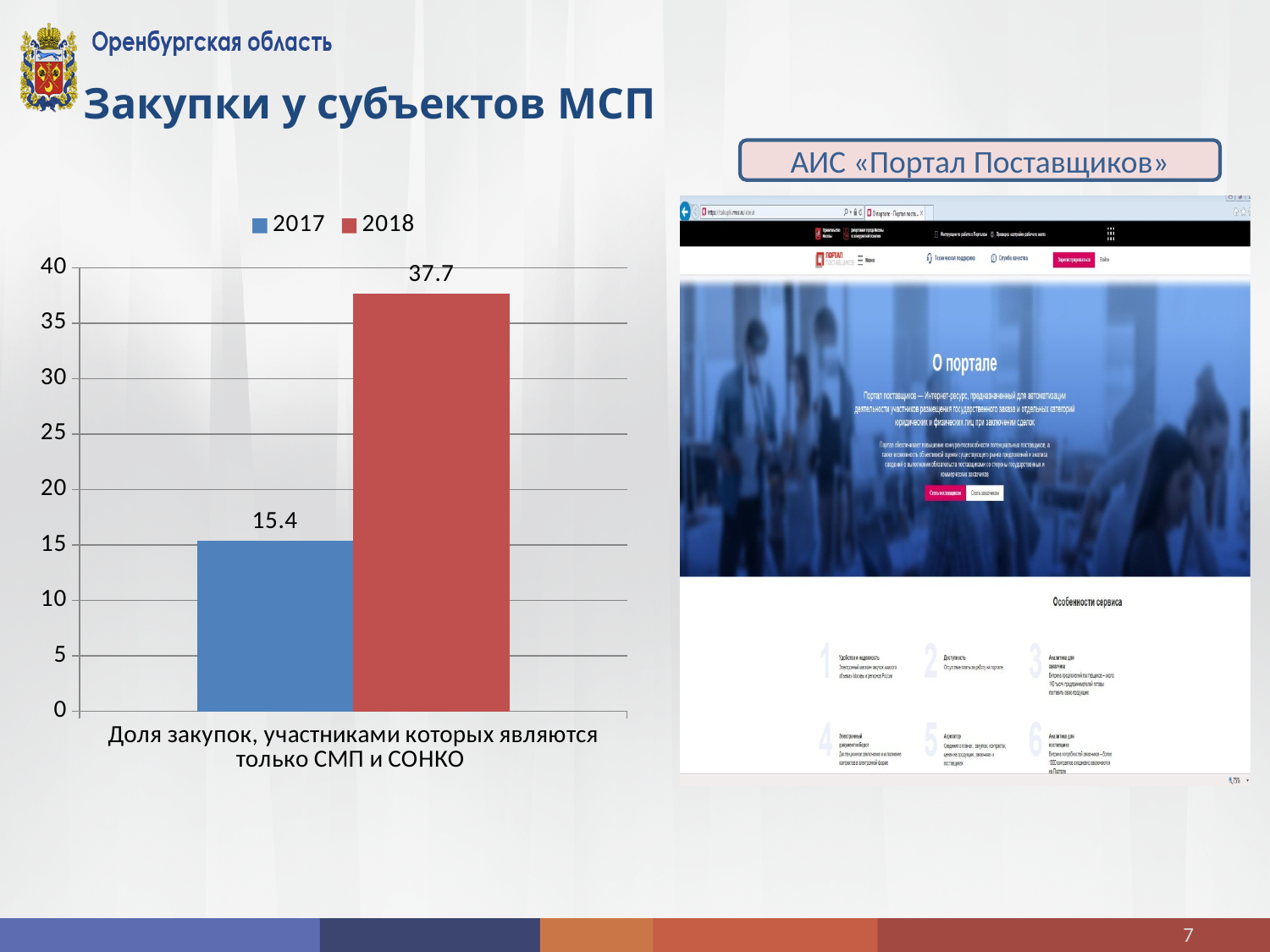
How many series does the legend list? 2 Did the value rise or fall from 2017 to 2018? rise How many categories are shown on the x axis of the chart? 1 Is the value for 2017 greater or less than 20? less What kind of chart is shown on the slide? bar chart Is the value for 2018 greater or less than 35? greater Which series has the higher value, 2017 or 2018? 2018 What colour is the bar for 2018? red What is the value for 2018 in the chart? 37.7 What is the difference between the 2018 and 2017 values? 22.3 What is the value for 2017 in the chart? 15.4 What is the category label on the x axis of the chart? Доля закупок, участниками которых являются только СМП и СОНКО